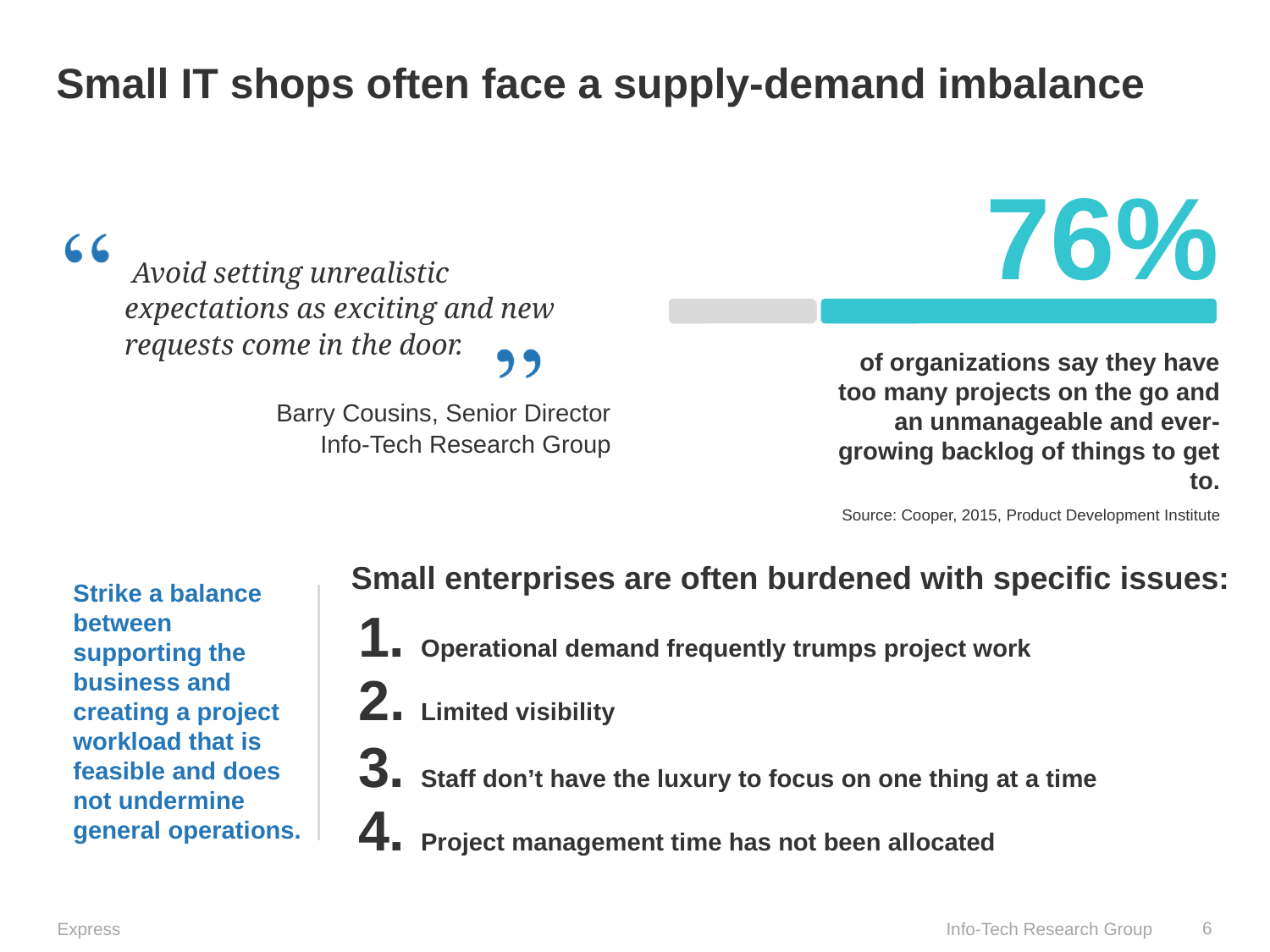
Is the value shown by the filled portion of the bar greater or less than 50%? greater What source is cited beneath the 76% statistic? Cooper, 2015, Product Development Institute What percentage is displayed above the horizontal bar on the slide? 76% What share of organizations say they have too many projects on the go and an unmanageable, ever-growing backlog? 76% What kind of chart is used to show the 76% statistic? bar chart What colour is the filled portion of the bar representing 76%? teal